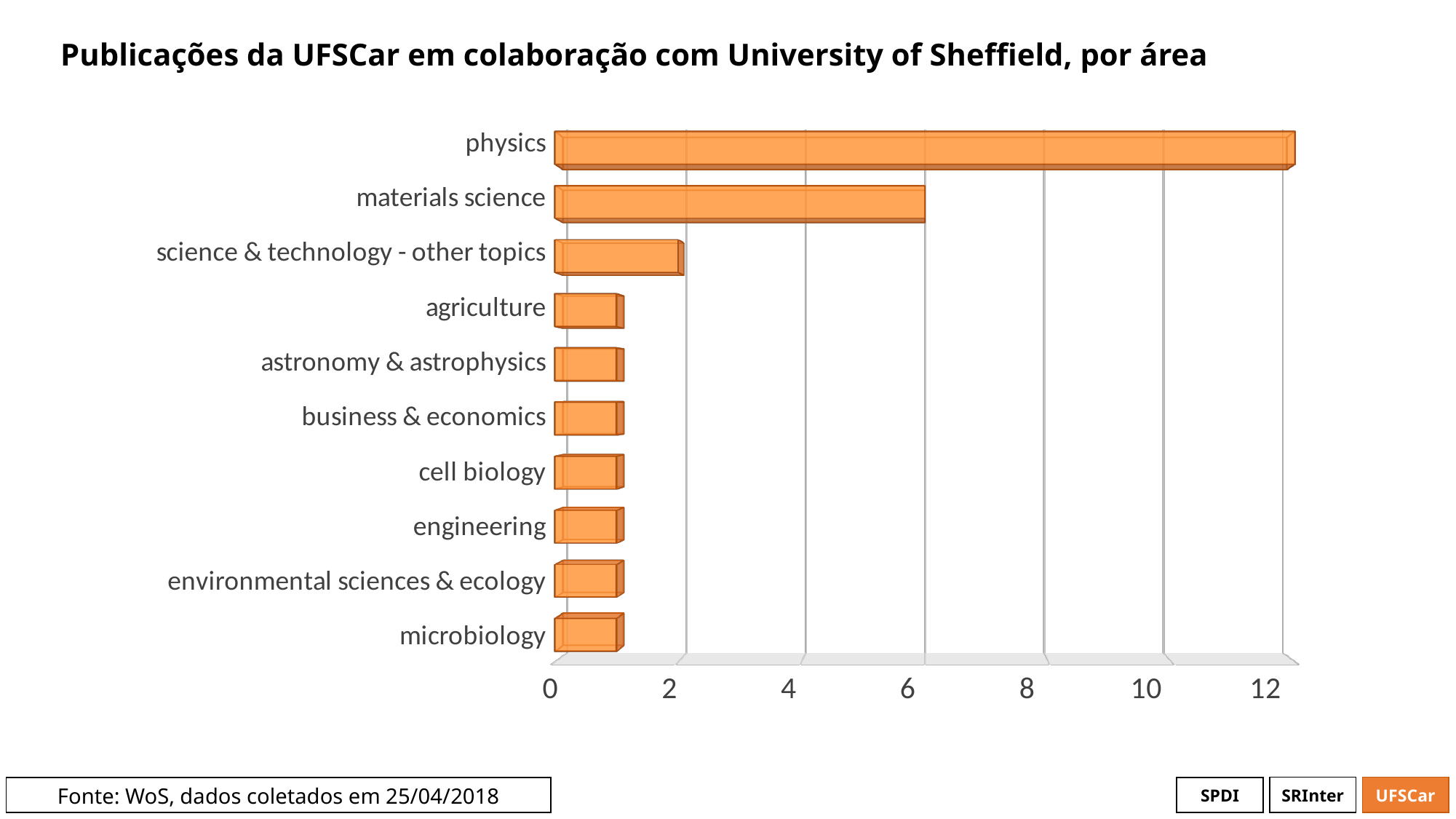
Is the value for physics greater or less than 10? greater Which is larger, the value for physics or the value for materials science? physics Is the value for microbiology greater or less than 2? less What is the value for science & technology - other topics? 2 Which area has the highest number of publications? physics What is the value for materials science? 6 What is the title of the chart? Publicações da UFSCar em colaboração com University of Sheffield, por área What kind of chart is shown on the slide? bar chart What is the difference between the values for materials science and science & technology - other topics? 4 Is the value for agriculture greater or less than 2? less Which is larger, the value for materials science or the value for engineering? materials science How many areas (categories) are shown in the chart? 10